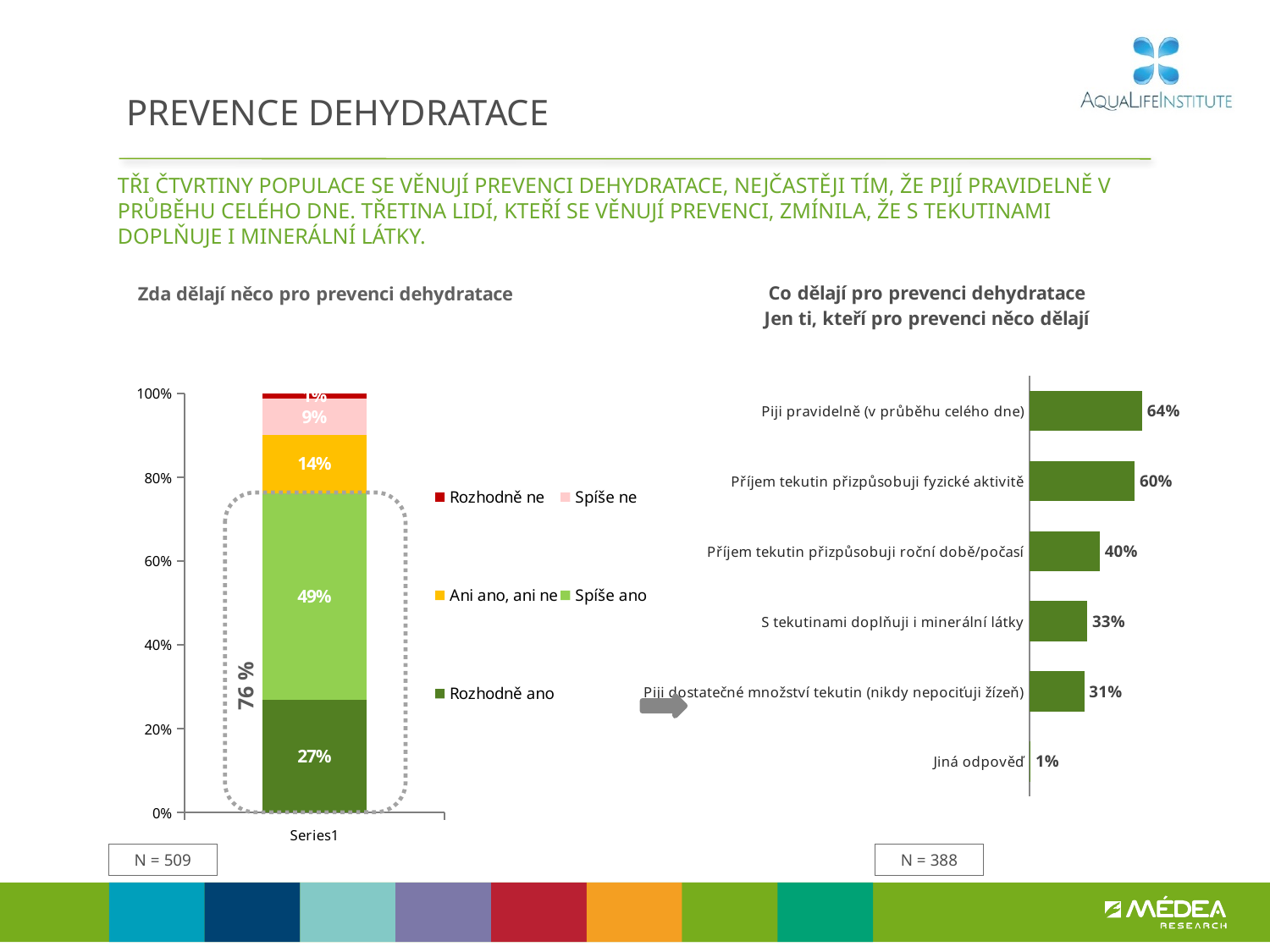
In the chart 'Co dělají pro prevenci dehydratace', what is the value for 'S tekutinami doplňuji i minerální látky'? 33% What kind of chart is 'Co dělají pro prevenci dehydratace'? Bar chart In the chart 'Zda dělají něco pro prevenci dehydratace', what is the value for 'Spíše ano'? 49% In the chart 'Co dělají pro prevenci dehydratace', which category has the highest value? Piji pravidelně (v průběhu celého dne) In the chart 'Co dělají pro prevenci dehydratace', how many categories are shown? 6 In the chart 'Co dělají pro prevenci dehydratace', which category has the lowest value? Jiná odpověď In the chart 'Zda dělají něco pro prevenci dehydratace', how many series does the legend list? 5 In the chart 'Co dělají pro prevenci dehydratace', what is the value for 'Piji pravidelně (v průběhu celého dne)'? 64% In the chart 'Zda dělají něco pro prevenci dehydratace', what is the combined value of 'Rozhodně ano' and 'Spíše ano'? 76% In the chart 'Zda dělají něco pro prevenci dehydratace', which is larger: 'Ani ano, ani ne' or 'Spíše ne'? Ani ano, ani ne In the chart 'Co dělají pro prevenci dehydratace', what is the difference between 'Příjem tekutin přizpůsobuji fyzické aktivitě' and 'Příjem tekutin přizpůsobuji roční době/počasí'? 20% In the chart 'Zda dělají něco pro prevenci dehydratace', what is the value for 'Rozhodně ano'? 27%